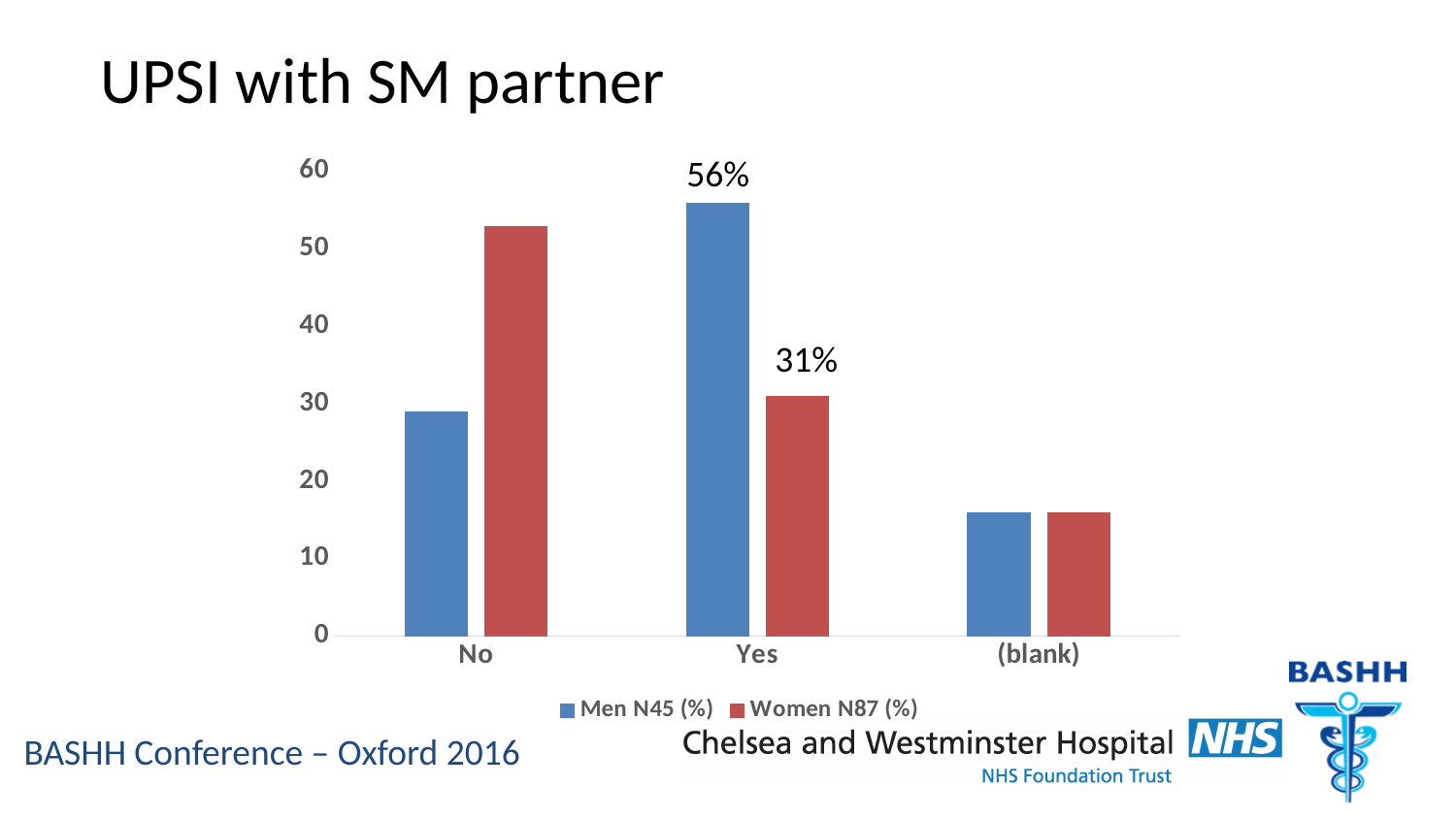
Is the value for Men N45 (%) in the (blank) category greater or less than 20? less How many series does the legend list? 2 In the Yes category, which series has the larger value, Men N45 (%) or Women N87 (%)? Men N45 (%) In the No category, which series has the larger value, Men N45 (%) or Women N87 (%)? Women N87 (%) Is the value for Women N87 (%) in the No category greater or less than 50? greater What is the value for Men N45 (%) in the Yes category? 56% What is the value for Women N87 (%) in the Yes category? 31% How many categories are shown on the x axis? 3 Which category has the lowest value for Women N87 (%)? (blank) Which category has the highest value for Men N45 (%)? Yes What is the difference between the Men N45 (%) and Women N87 (%) values in the Yes category? 25%